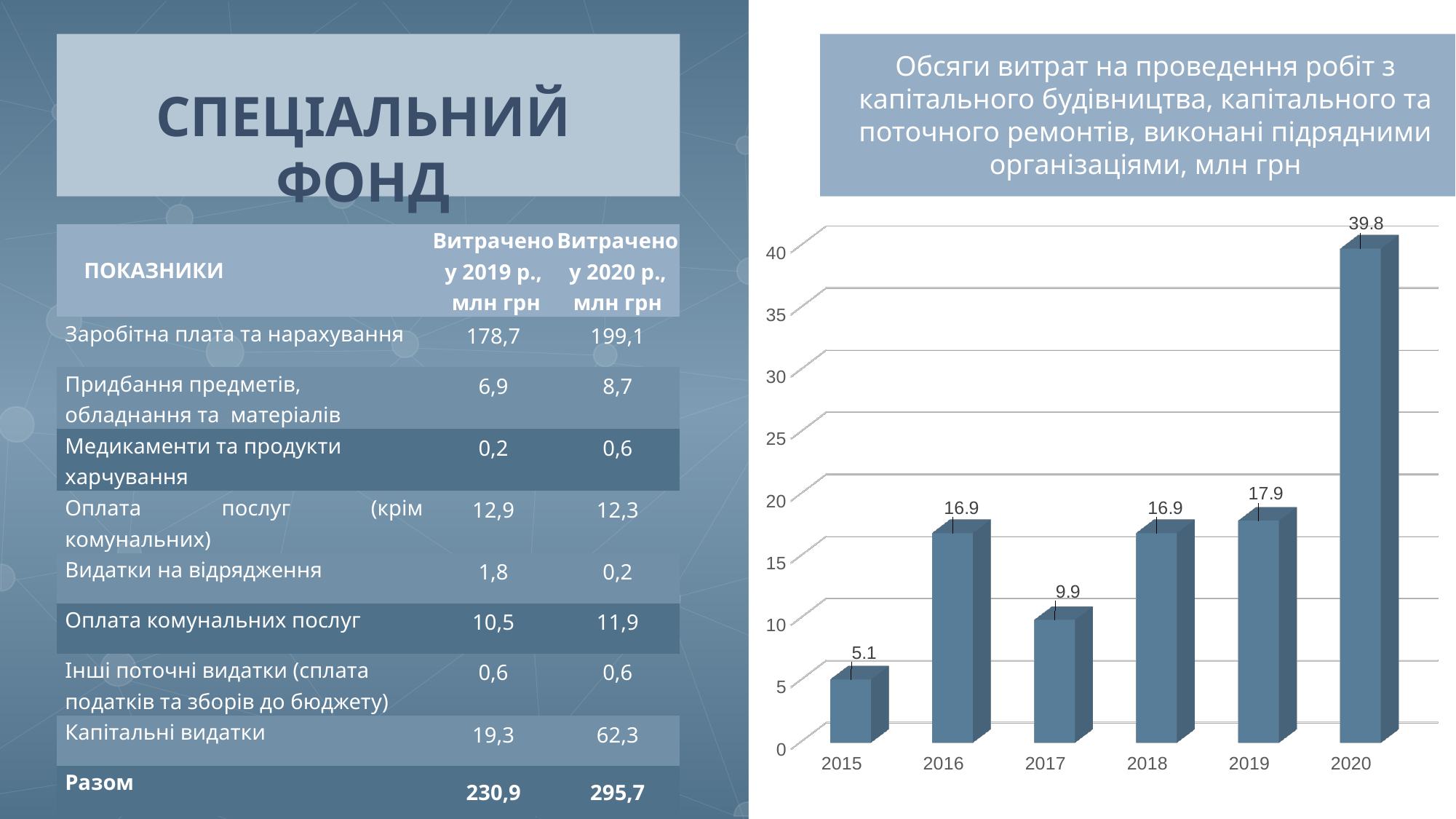
What kind of chart is shown on the slide? bar chart What is the value for 2015 in the chart? 5.1 What is the value for 2017 in the chart? 9.9 What is the value for 2020 in the chart? 39.8 Which year has the lowest value in the chart? 2015 What is the difference between the values for 2020 and 2019? 21.9 How many years are shown on the x axis of the chart? 6 Which year has the highest value in the chart? 2020 Which is larger, the value for 2017 or the value for 2018? 2018 What is the difference between the values for 2016 and 2017? 7 What is the value for 2019 in the chart? 17.9 Is the value for 2019 greater or less than 15? greater